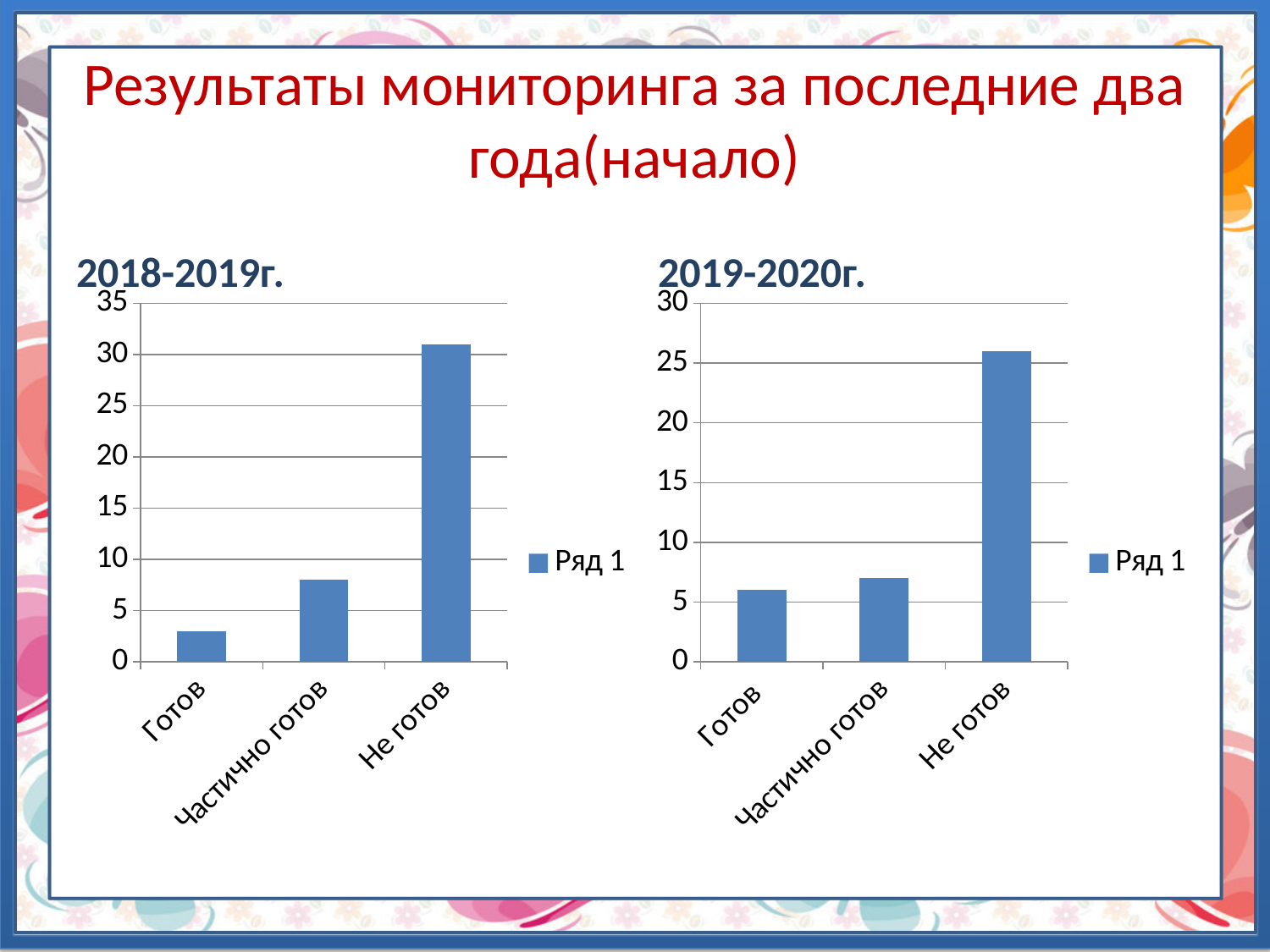
In the 2019-2020г. chart, which category has the highest value? Не готов In the 2018-2019г. chart, which category has the highest value? Не готов How many categories are shown in the 2019-2020г. chart? 3 What type of chart is the 2019-2020г. chart? bar chart How many series does the legend of the 2018-2019г. chart list? 1 In the 2018-2019г. chart, which is larger, the value for Частично готов or the value for Готов? Частично готов In the 2018-2019г. chart, is the value for Не готов greater or less than 30? greater What is the legend entry shown in the 2019-2020г. chart? Ряд 1 In the 2018-2019г. chart, which category has the lowest value? Готов In the 2019-2020г. chart, is the value for Частично готов greater or less than 10? less In the 2019-2020г. chart, is the value for Не готов greater or less than 25? greater